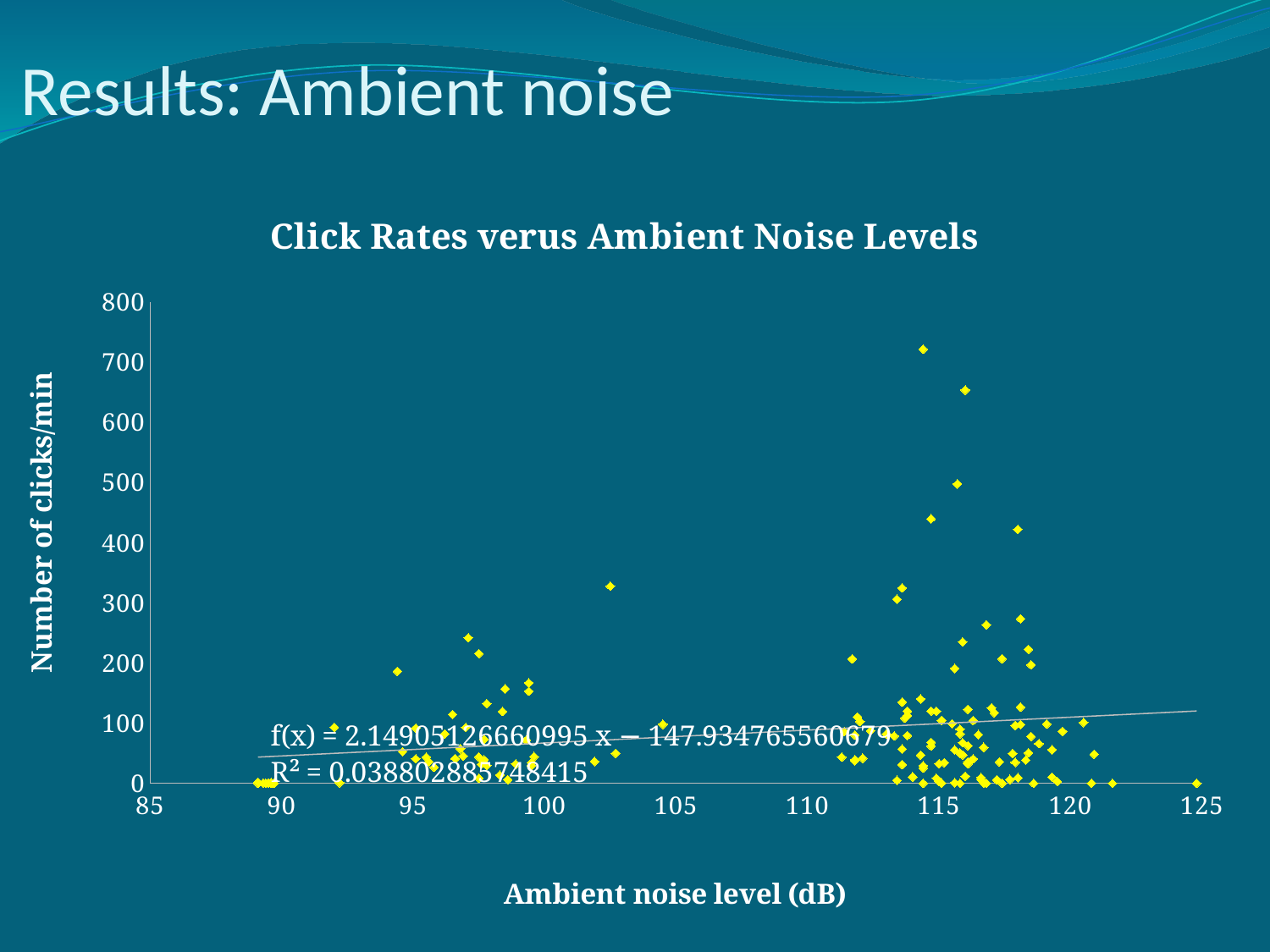
Is the number of clicks/min for the isolated point near 102.5 dB greater or less than 300? greater What is the highest value shown on the y axis? 800 Is the highest plotted point's number of clicks/min greater or less than 800? less What is the title of the chart? Click Rates verus Ambient Noise Levels Is the number of clicks/min for the isolated point near 102.5 dB greater or less than 400? less Does the fitted trendline rise or fall as ambient noise level increases? rises What is the label of the x axis? Ambient noise level (dB) Is the slope of the fitted line f(x) positive or negative? positive What kind of chart is shown on the slide? scatter plot What is the highest value shown on the x axis? 125